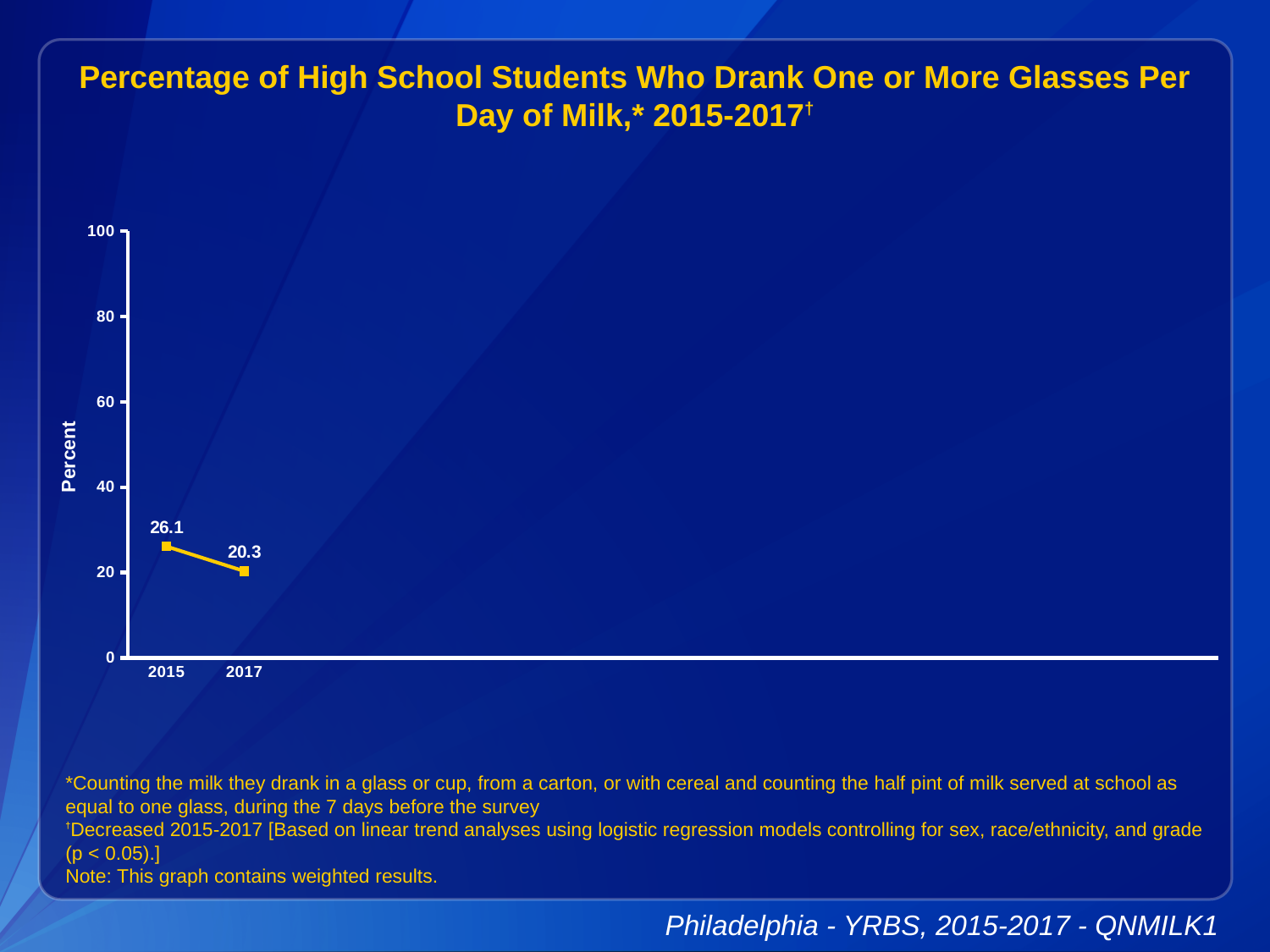
Which year has the highest value? 2015 Is the value for 2017 greater or less than 20? greater What is the value for 2017? 20.3 How many data points are plotted on the chart? 2 Which is larger, the value for 2015 or the value for 2017? 2015 What kind of chart is shown? line chart What is the difference between the 2015 and 2017 values? 5.8 Is the value for 2015 greater or less than 40? less What is the label on the y axis? Percent Do the values rise or fall from 2015 to 2017? fall What is the value for 2015? 26.1 Which year has the lowest value? 2017